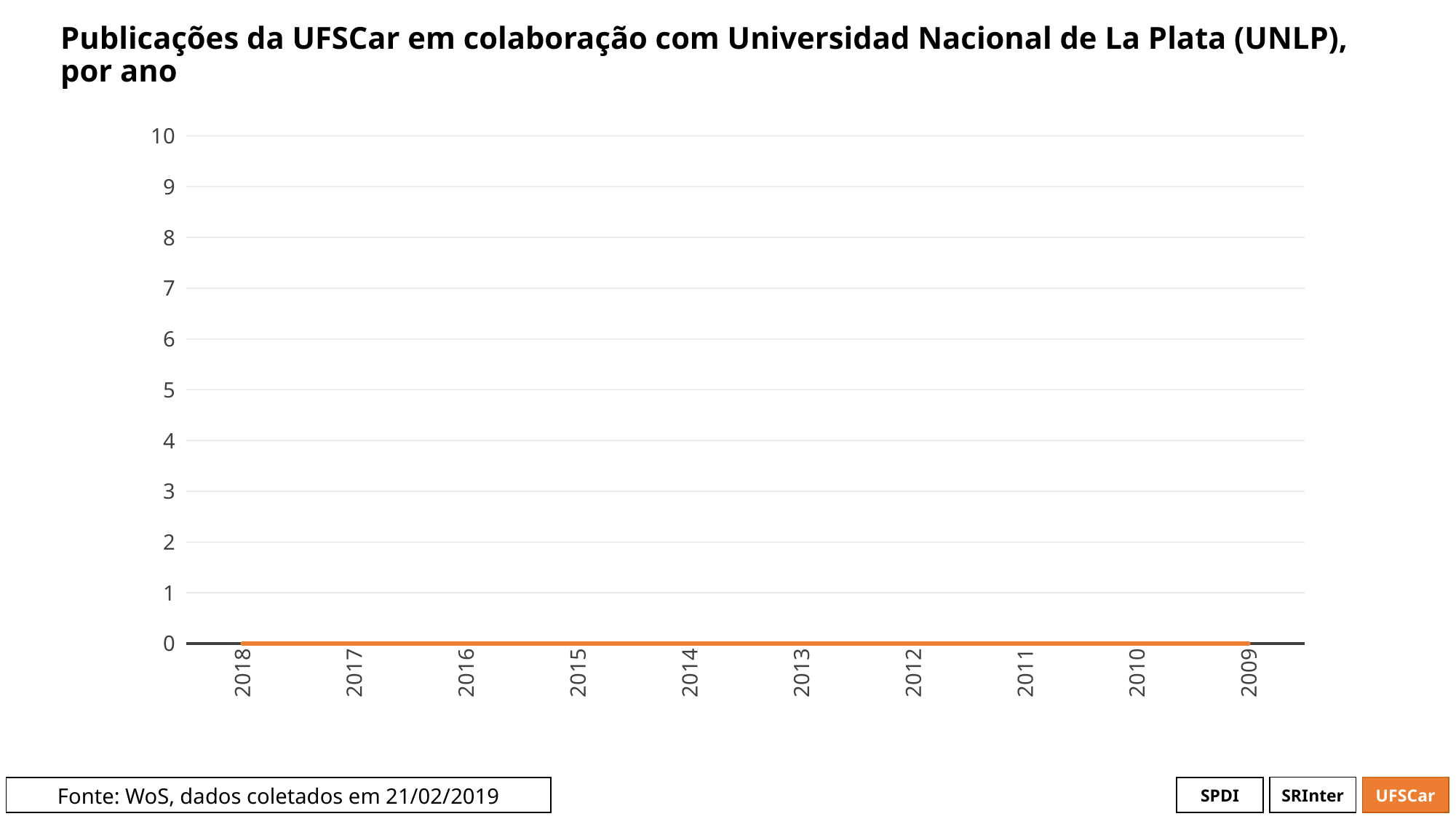
Is the value for 2015 greater or less than 5? less Is the value for 2011 greater or less than 1? less Which year is the leftmost on the x axis? 2018 What kind of chart is shown on the slide? line chart What is the highest value shown on the y axis of the chart? 10 What is the value for 2009 in the chart? 0 How many years are shown on the x axis of the chart? 10 Do the values rise, fall or stay flat across the years shown? stay flat What is the value for 2014 in the chart? 0 What is the title of the chart? Publicações da UFSCar em colaboração com Universidad Nacional de La Plata (UNLP), por ano What is the value for 2018 in the chart? 0